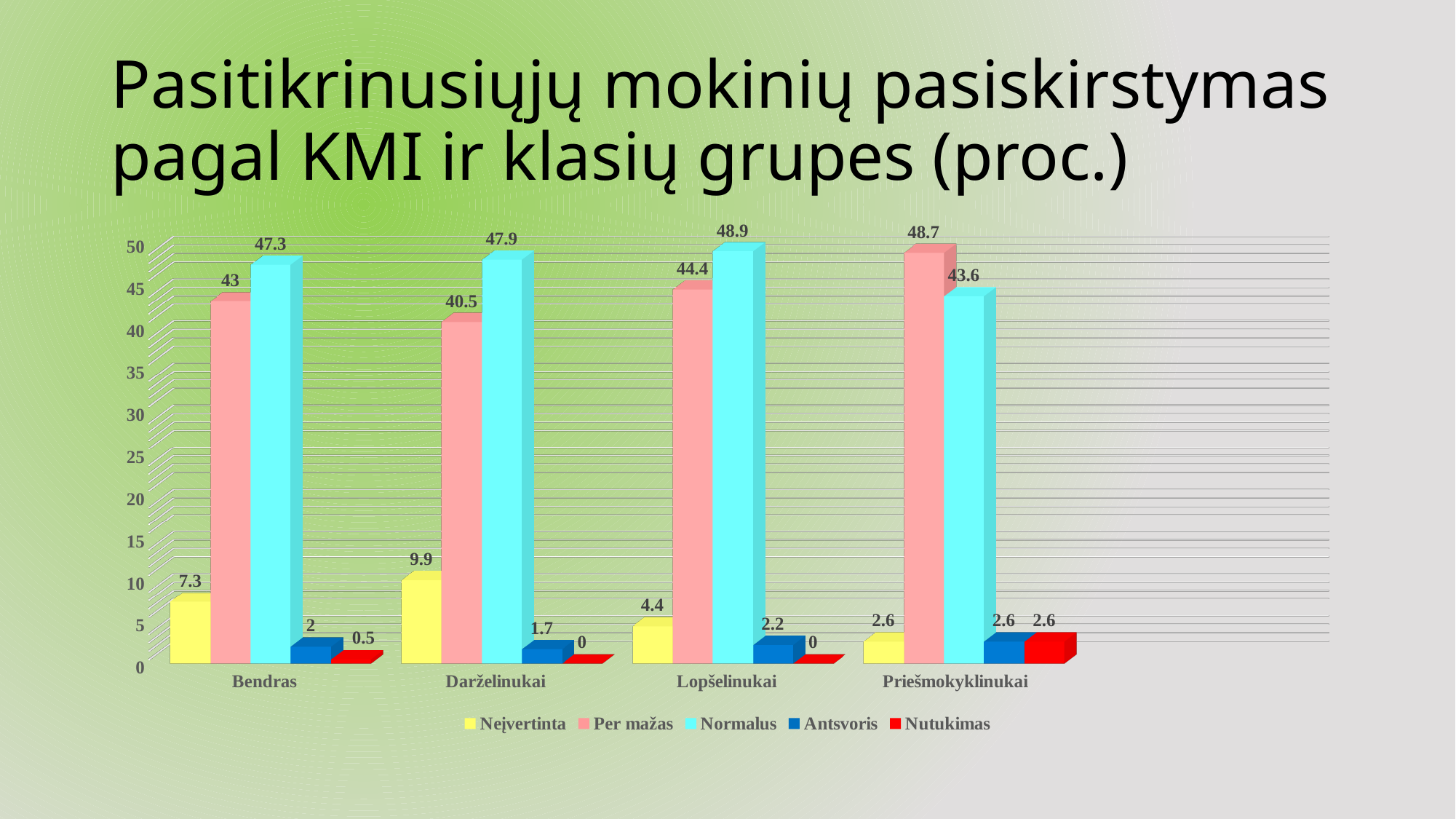
What is the difference between the Normalus and Per mažas values in the Bendras group? 4.3 What is the value for Neįvertinta in the Darželinukai group? 9.9 Which group has the highest value for Normalus? Lopšelinukai How many series does the legend list? 5 Which is larger in the Priešmokyklinukai group, Per mažas or Normalus? Per mažas Which group has the lowest value for Neįvertinta? Priešmokyklinukai How many class groups are shown on the x axis? 4 What is the value for Normalus in the Lopšelinukai group? 48.9 Which series is shown in red in the legend? Nutukimas What kind of chart is shown on the slide? Bar chart What is the value for Nutukimas in the Bendras group? 0.5 What is the value for Per mažas in the Priešmokyklinukai group? 48.7